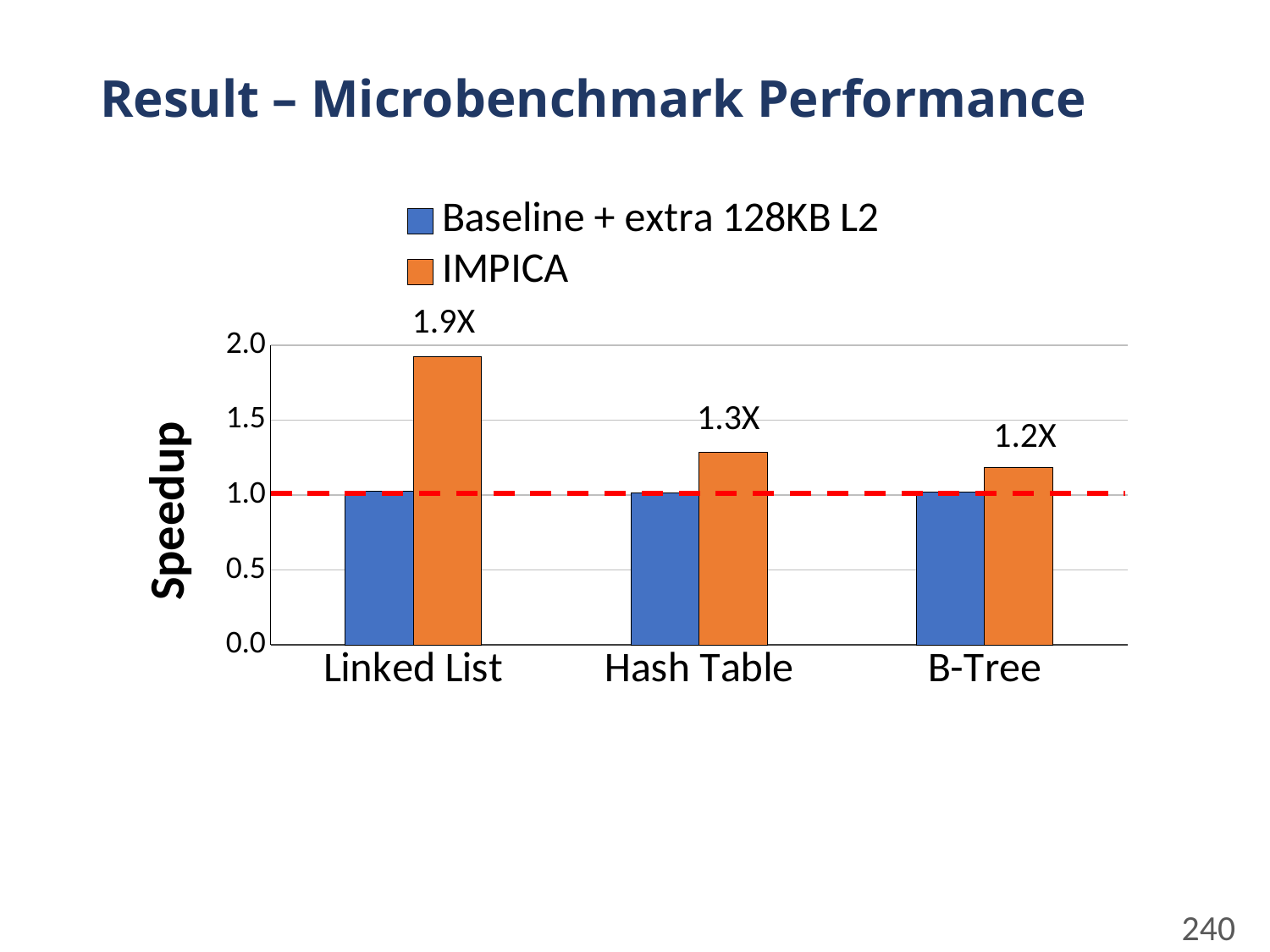
Which benchmark has the highest IMPICA speedup? Linked List What is the IMPICA speedup for Hash Table? 1.3X What kind of chart is shown on the slide? bar chart How many benchmarks are shown on the x axis? 3 Which benchmark has the lowest IMPICA speedup? B-Tree What is the IMPICA speedup for B-Tree? 1.2X Which is larger for Linked List, the IMPICA bar or the Baseline + extra 128KB L2 bar? IMPICA How many series does the legend list? 2 What is the IMPICA speedup for Linked List? 1.9X Is the IMPICA speedup for Linked List greater or less than 1.5? greater What is the label of the y axis? Speedup Is the IMPICA speedup for Hash Table greater or less than 1.5? less